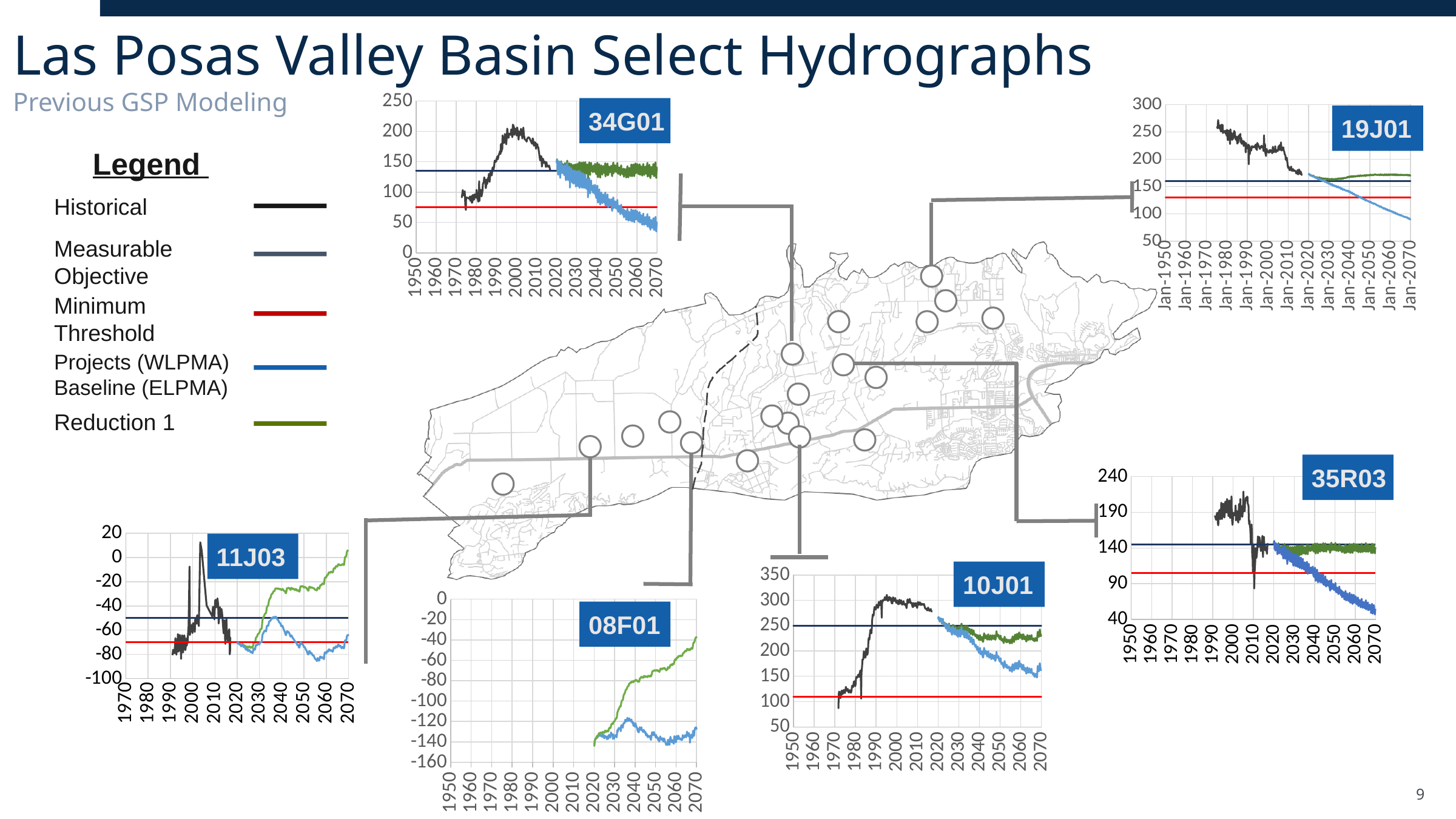
How many hydrograph charts are shown on the slide? 6 In the 34G01 chart, does the Projects (WLPMA) blue line rise or fall from 2020 to 2070? fall In the Legend, what colour is the Reduction 1 line? green In the 34G01 chart, is the peak of the Historical (black) line around 2000 greater or less than 150? greater In the 35R03 chart, is the value of the blue line at 2070 greater or less than 90? less In the Legend, what colour is the Minimum Threshold line? red In the 08F01 chart, does the Reduction 1 (green) line rise or fall from 2020 to 2070? rise In the 34G01 chart, is the Minimum Threshold (red) line greater or less than 100? less What kind of chart is the 34G01 hydrograph? line chart